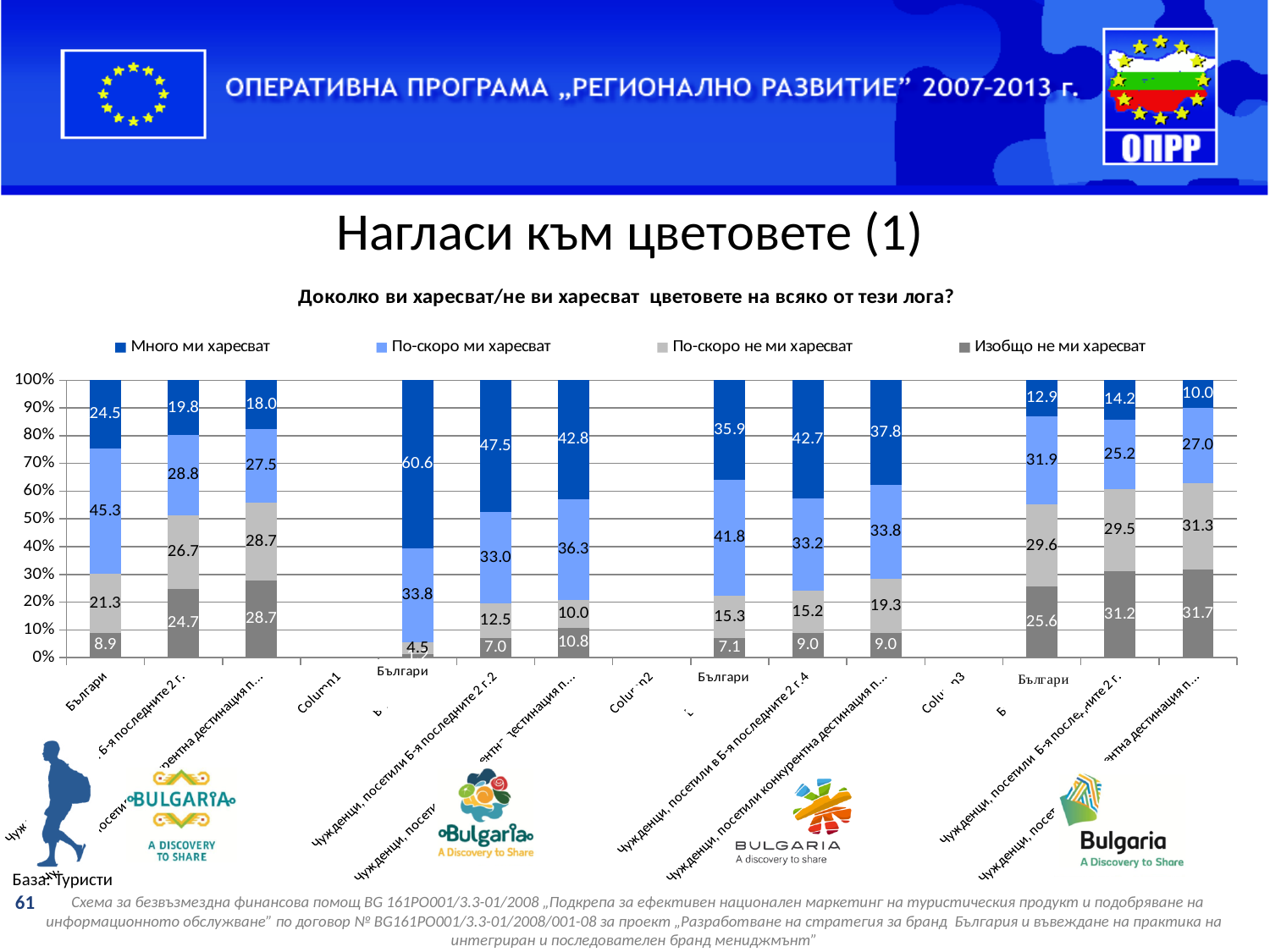
In the leftmost group of bars, what is the 'Изобщо не ми харесват' value for 'Българи'? 8.9 In the second group of bars, is the 'Много ми харесват' value larger for 'Българи' or for 'Чужденци, посетили Б-я последните 2 г.'? Българи Across all bars, which bar has the lowest 'Изобщо не ми харесват' value? Българи in the second group (1.2) In the leftmost group of bars, what is the 'Много ми харесват' value for 'Българи'? 24.5 In the rightmost group of bars, what is the 'Изобщо не ми харесват' value for 'Българи'? 25.6 What kind of chart is shown on the slide? Stacked bar chart In the leftmost group, what is the difference between the 'По-скоро ми харесват' and 'По-скоро не ми харесват' values for 'Българи'? 24.0 In the second group of bars from the left, what is the 'Много ми харесват' value for 'Българи'? 60.6 How many series does the chart legend list? 4 What is the chart's title (the question above the chart)? Доколко ви харесват/не ви харесват цветовете на всяко от тези лога? Across all bars, which bar has the highest 'Много ми харесват' value? Българи in the second group (60.6) What is the first entry in the chart legend? Много ми харесват